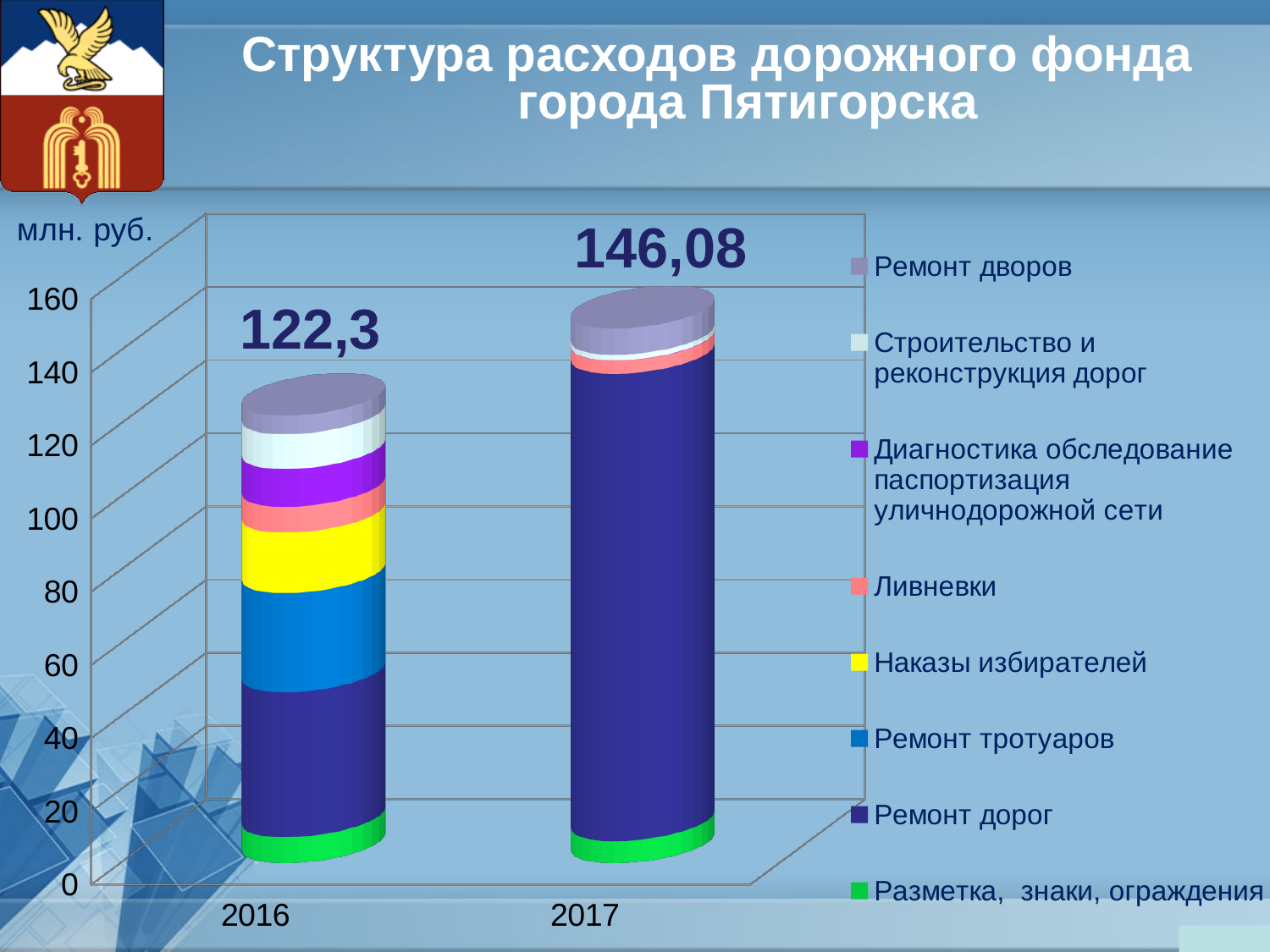
How many series does the legend list? 8 What unit is indicated for the values on the chart? млн. руб. By how much does the 2017 total exceed the 2016 total? 23,78 Is the value for Ремонт тротуаров in 2016 greater or less than 60? less Does the total expenditure rise or fall from 2016 to 2017? rise How many years (categories) are plotted on the chart? 2 Is the Ремонт дорог segment larger in 2016 or in 2017? 2017 What is the total value shown for 2017? 146,08 Which year has the higher total expenditure? 2017 What is the total value shown for 2016? 122,3 What kind of chart is shown on the slide? stacked bar chart Is the value for Ремонт дорог in 2017 greater or less than 100? greater